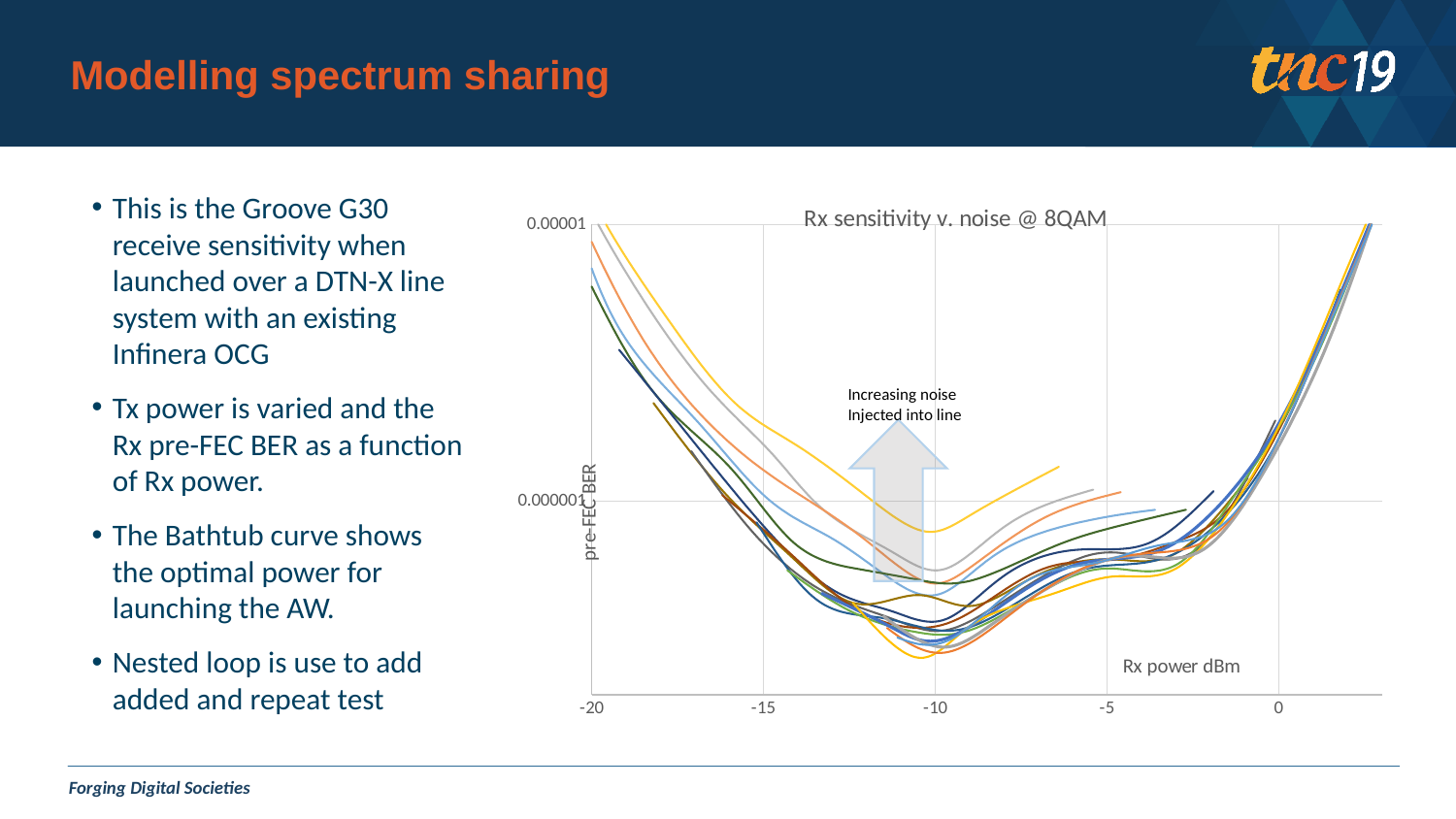
At an Rx power of -20 dBm, is the pre-FEC BER of the curves greater or less than 0.000001? greater What is the highest value labelled on the y axis of the chart? 0.00001 Do the curves rise or fall as Rx power increases from -20 dBm to -10 dBm? fall How many labelled tick marks are shown on the x axis of the chart? 5 What kind of chart is shown on the slide? line chart What is the lowest value labelled on the x axis of the chart? -20 What label is shown on the x axis of the chart? Rx power dBm Do the curves rise or fall as Rx power increases from -5 dBm to 0 dBm? rise What is the title of the chart? Rx sensitivity v. noise @ 8QAM